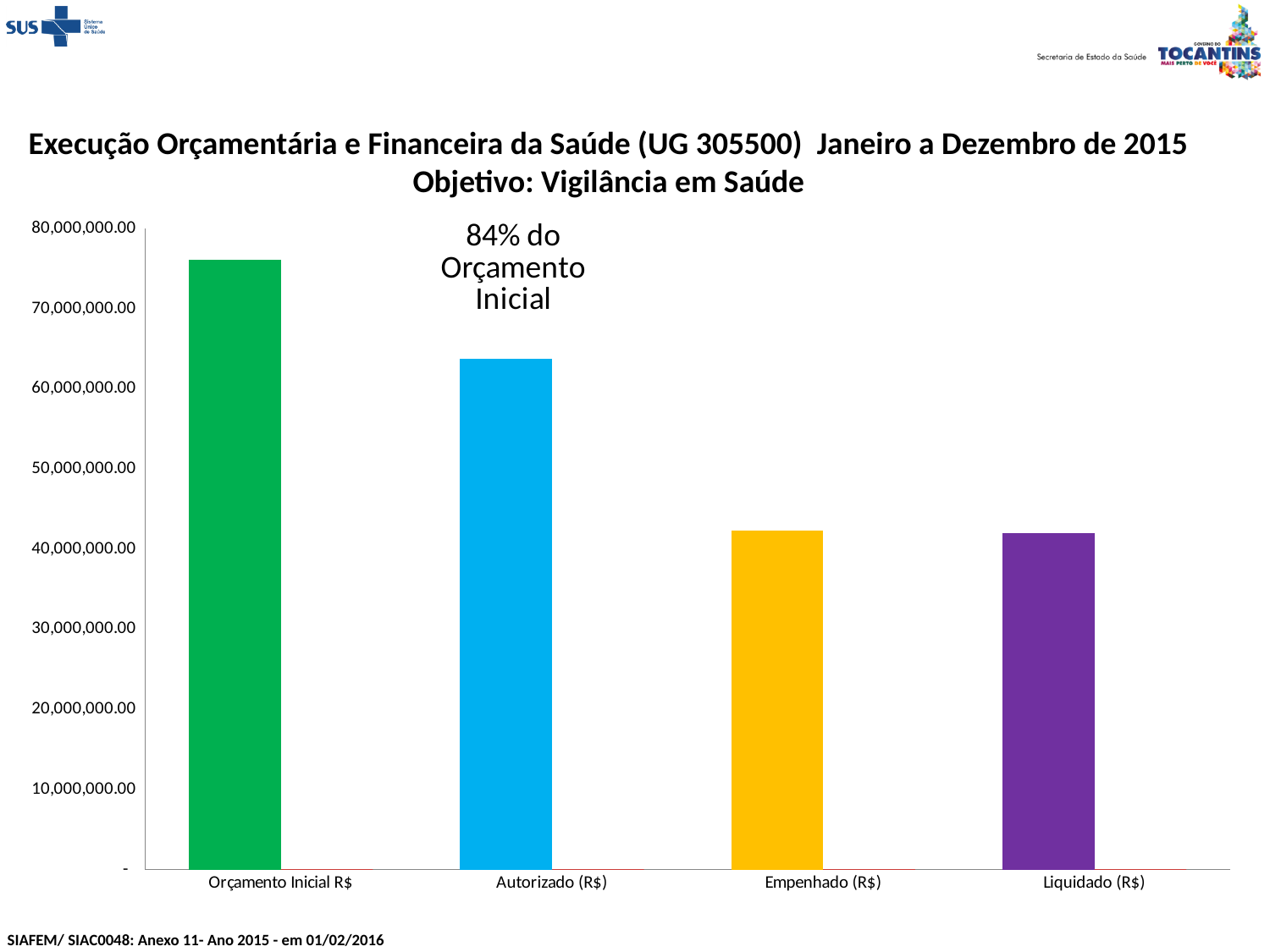
Do the bar values generally rise or fall from left to right across the categories? fall Which is larger, Autorizado (R$) or Empenhado (R$)? Autorizado (R$) Which category has the highest value? Orçamento Inicial R$ Which is larger, Orçamento Inicial R$ or Autorizado (R$)? Orçamento Inicial R$ Is the value for Autorizado (R$) greater or less than 60,000,000.00? greater What kind of chart is shown on the slide? bar chart Is the value for Empenhado (R$) greater or less than 50,000,000.00? less What colour is the bar for Empenhado (R$)? yellow What percentage of the Orçamento Inicial does the annotation above the Autorizado bar state? 84% Is the value for Orçamento Inicial R$ greater or less than 70,000,000.00? greater How many bars (categories) does the chart show? 4